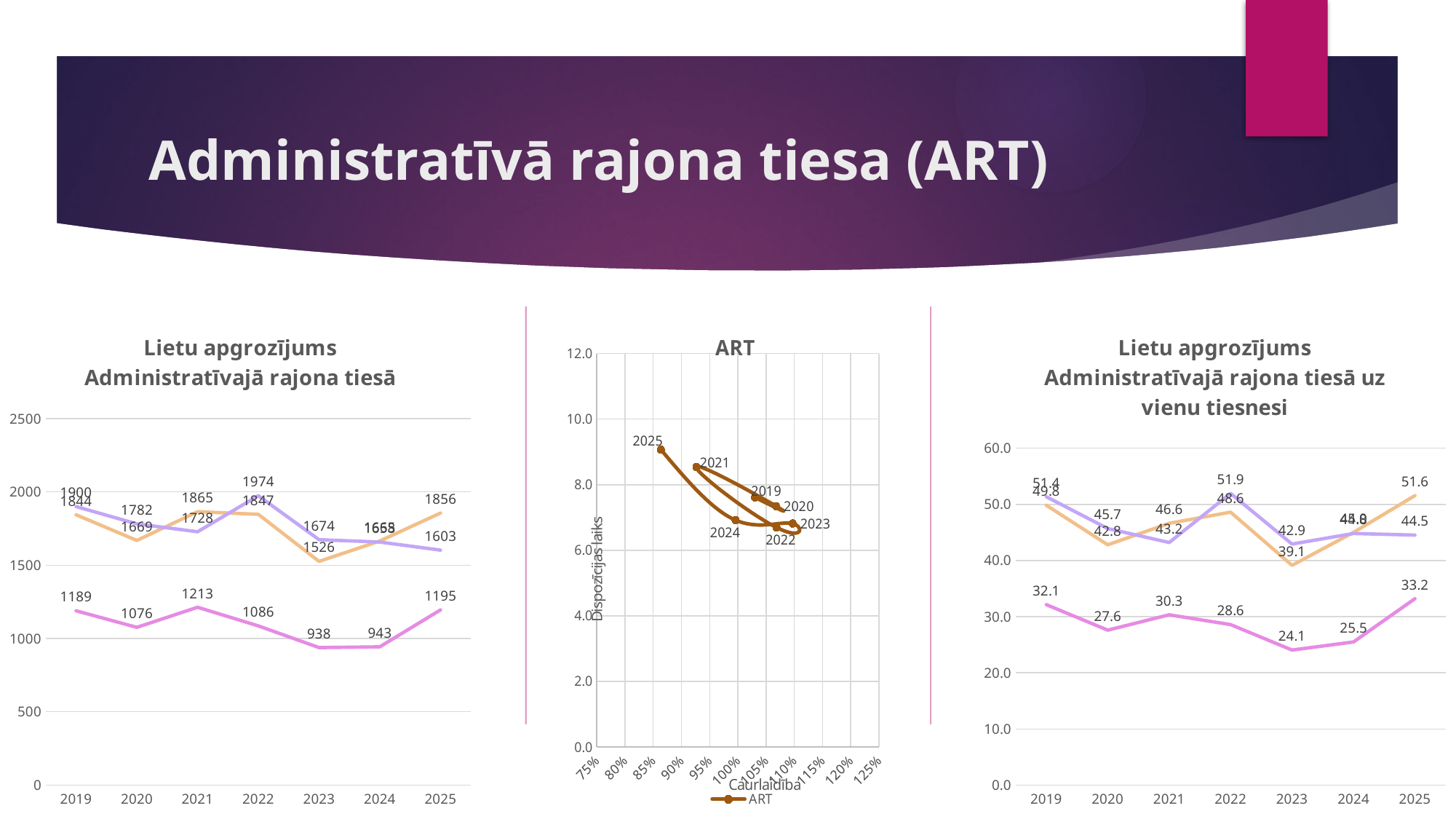
On the middle chart 'ART', is the Dispozīcijas laiks value for 2023 greater or less than 8.0? less On the left chart 'Lietu apgrozījums Administratīvajā rajona tiesā', what is the value of the pink line in 2023? 938 On the left chart 'Lietu apgrozījums Administratīvajā rajona tiesā', how many years are shown on the x axis? 7 On the left chart 'Lietu apgrozījums Administratīvajā rajona tiesā', what is the difference between the pink line's values in 2025 and 2024? 252 On the right chart 'Lietu apgrozījums Administratīvajā rajona tiesā uz vienu tiesnesi', what is the value of the orange line in 2023? 39.1 On the right chart 'Lietu apgrozījums Administratīvajā rajona tiesā uz vienu tiesnesi', which is larger for the pink line: 2019 or 2020? 2019 What kind of chart is the left chart 'Lietu apgrozījums Administratīvajā rajona tiesā'? line chart On the middle chart 'ART', is the Dispozīcijas laiks value for 2025 greater or less than 8.0? greater On the right chart 'Lietu apgrozījums Administratīvajā rajona tiesā uz vienu tiesnesi', what is the value of the pink line in 2025? 33.2 On the middle chart 'ART', what is the label of the x axis? Caurlaidība On the left chart 'Lietu apgrozījums Administratīvajā rajona tiesā', in which year is the pink line lowest? 2023 On the left chart 'Lietu apgrozījums Administratīvajā rajona tiesā', what is the value of the purple line in 2022? 1974